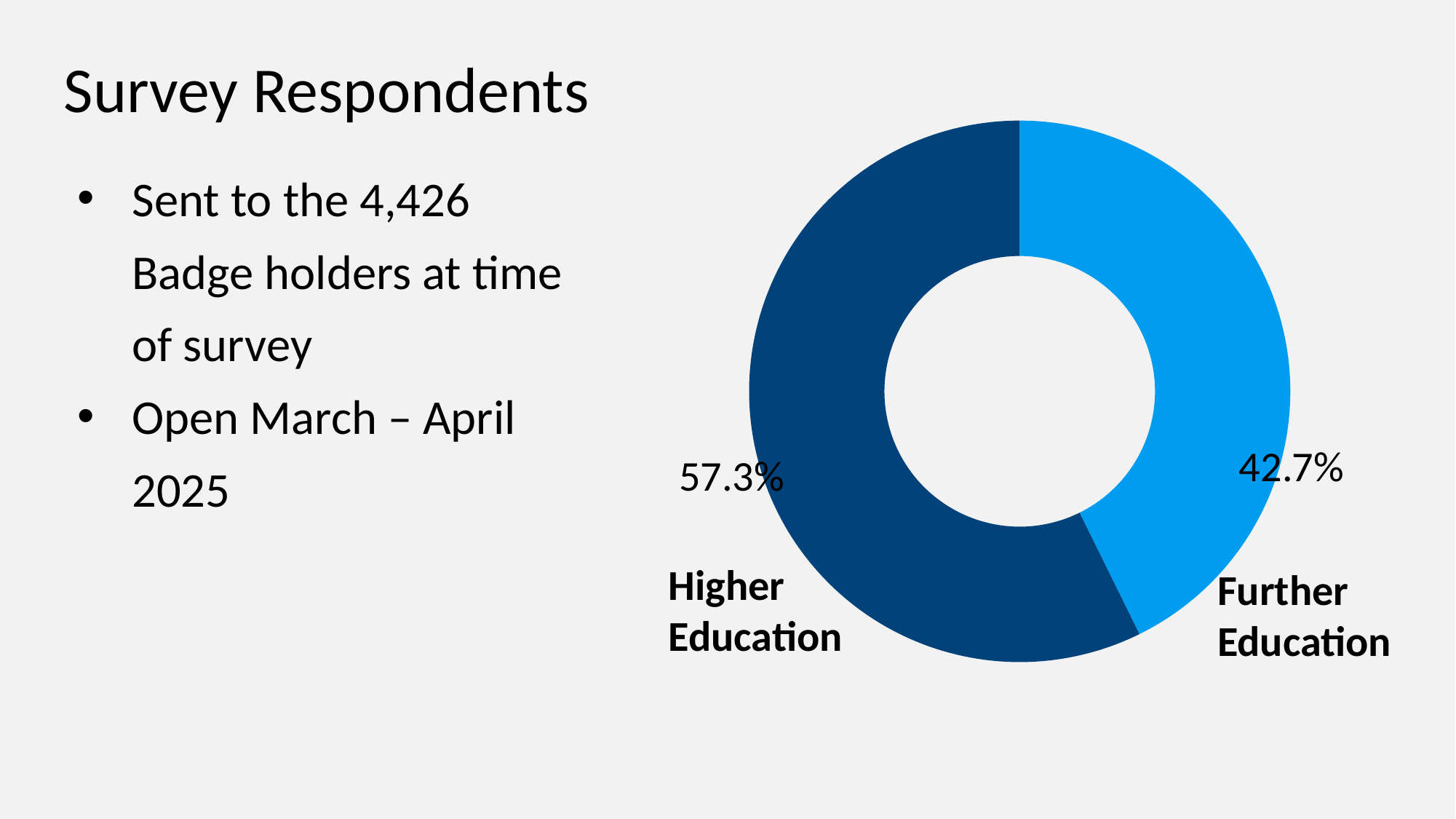
What is the title of the slide containing the chart? Survey Respondents What colour is the Further Education slice? Light blue What share of survey respondents are from Further Education? 42.7% What kind of chart is shown on the slide? Doughnut (pie) chart Which is larger, the Higher Education share or the Further Education share? Higher Education Which category has the smallest share of respondents? Further Education What is the difference in percentage points between the Higher Education and Further Education shares? 14.6 How many categories does the chart show? 2 Is the Higher Education share greater or less than 50%? greater Is the Further Education share greater or less than 50%? less Which category has the largest share of respondents? Higher Education What share of survey respondents are from Higher Education? 57.3%